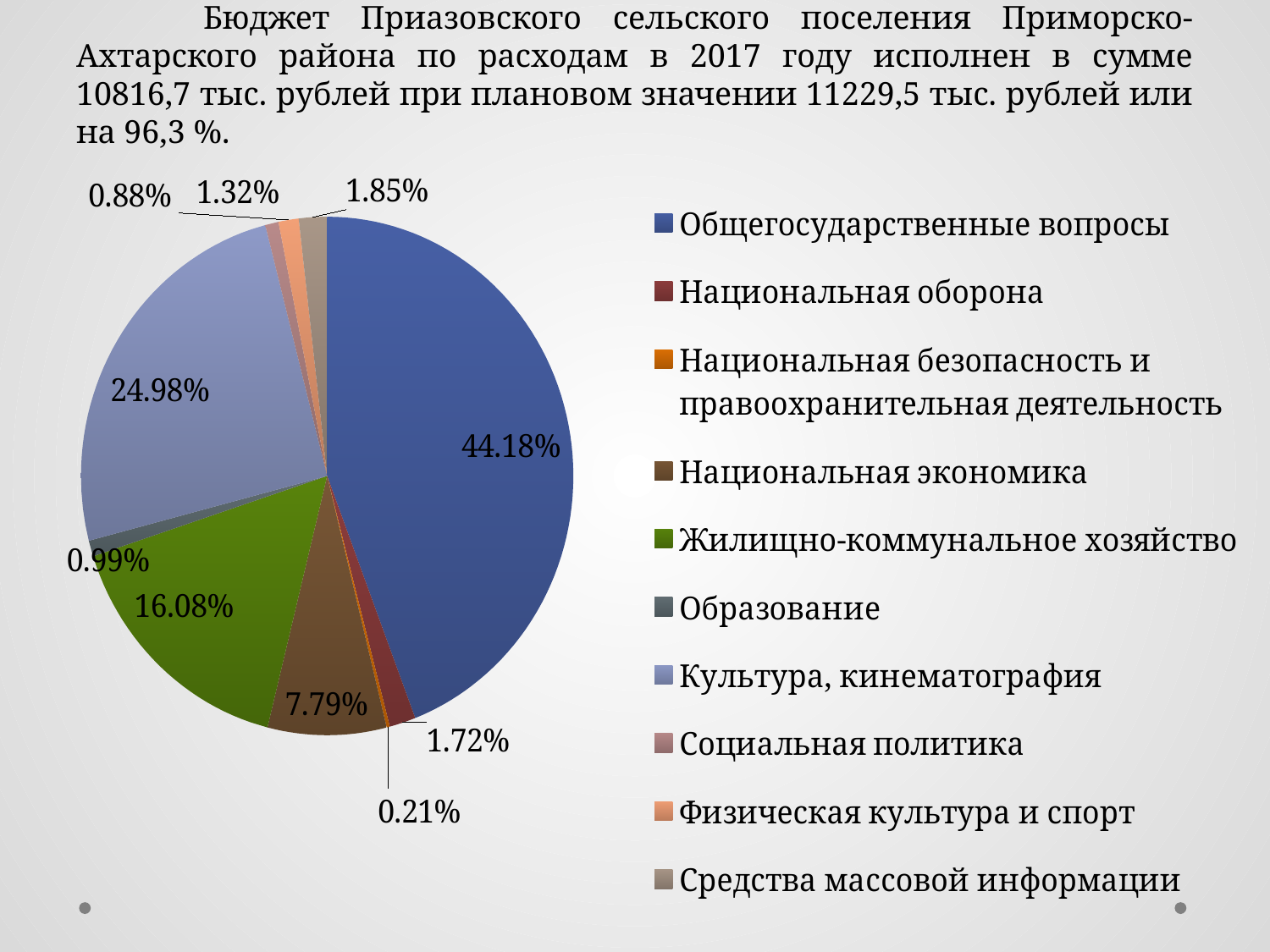
How many categories does the legend list? 10 Which category has the largest slice of the pie? Общегосударственные вопросы What colour is the slice for Жилищно-коммунальное хозяйство? Green What is the value shown for Национальная экономика? 7.79% Which is larger: the share for Национальная оборона or the share for Физическая культура и спорт? Национальная оборона What is the difference between the shares of Общегосударственные вопросы and Культура, кинематография? 19.20% What is the value shown for Жилищно-коммунальное хозяйство? 16.08% What share of the pie does Общегосударственные вопросы account for? 44.18% What is the value shown for Культура, кинематография? 24.98% What kind of chart is shown on the slide? Pie chart What is the value shown for Национальная безопасность и правоохранительная деятельность? 0.21% Which category has the smallest slice of the pie? Национальная безопасность и правоохранительная деятельность